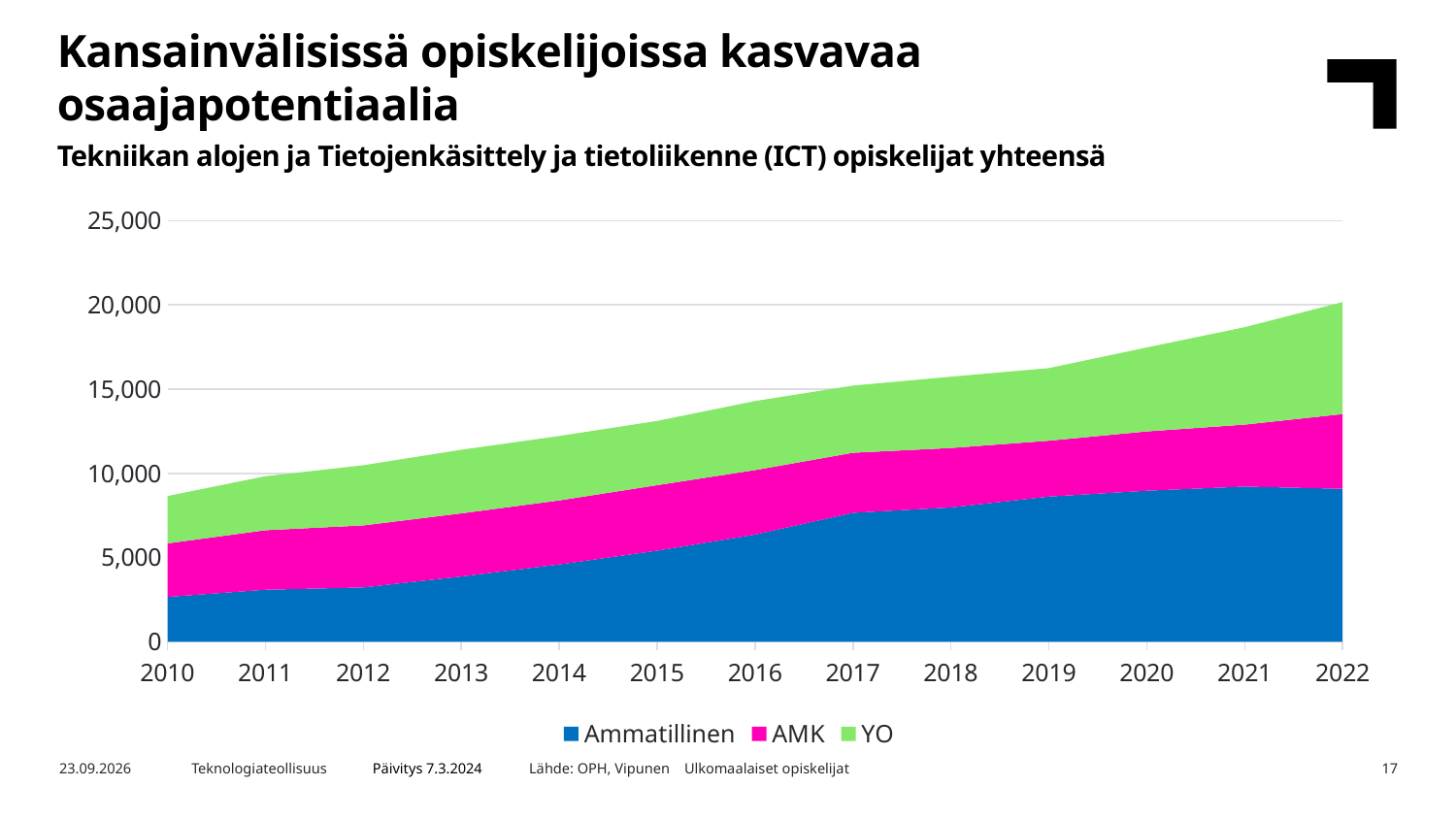
Which series are listed in the legend? Ammatillinen, AMK, YO What kind of chart is shown on the slide? Stacked area chart How many series does the legend list? 3 Is the value for Ammatillinen in 2010 greater or less than 5,000? less Does the total number of students rise or fall from 2010 to 2022? Rise Is the total value for 2015 greater or less than 10,000? greater Is the total value for 2010 greater or less than 10,000? less How many years are shown along the x axis? 13 What is the first year shown on the x axis? 2010